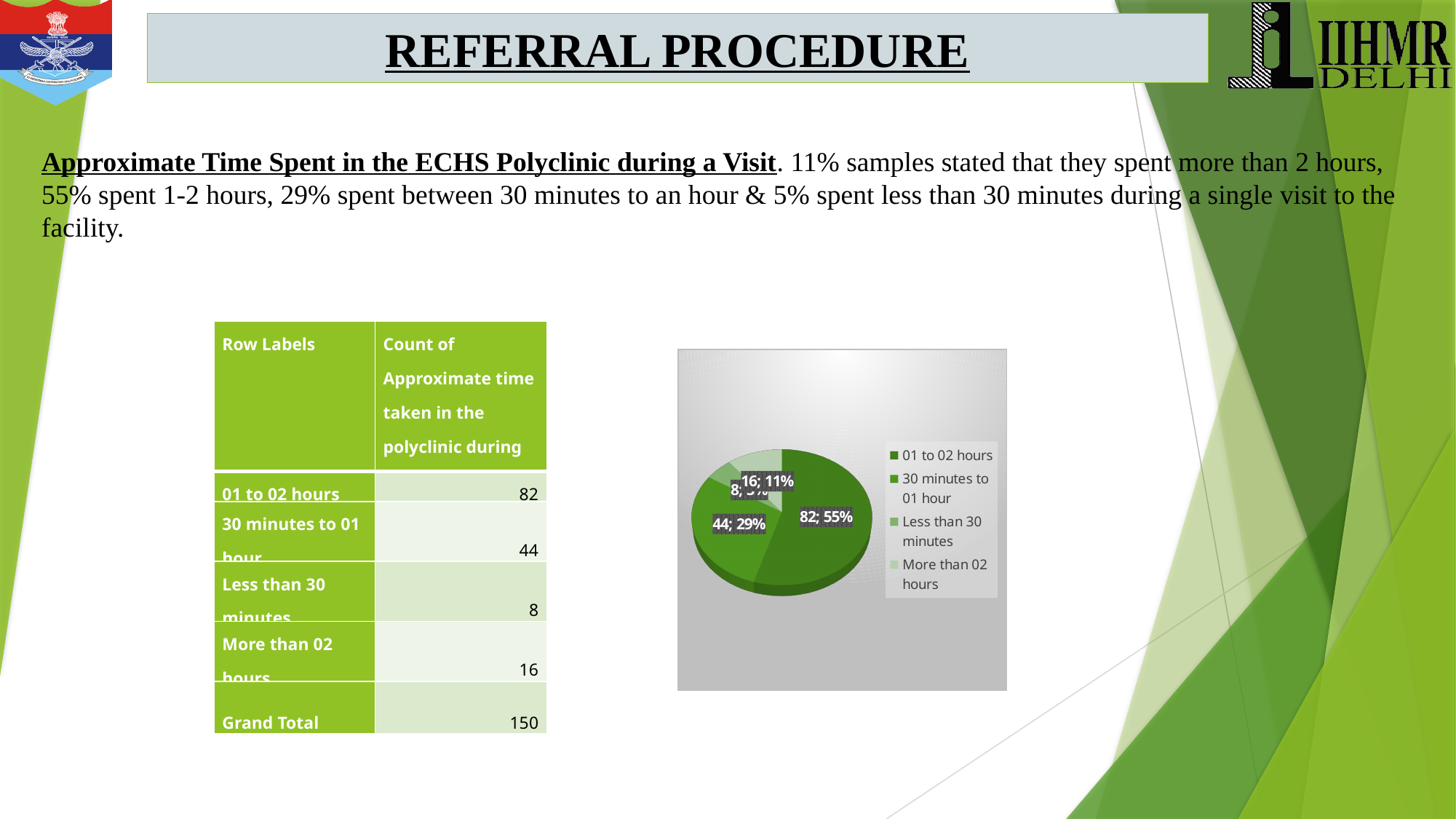
How many entries does the pie chart's legend list? 4 What kind of chart is shown on the slide? Pie chart In the pie chart, which is larger: the count for 'More than 02 hours' or the count for 'Less than 30 minutes'? More than 02 hours How many slices does the pie chart have? 4 What percentage share does the '01 to 02 hours' slice have in the pie chart? 55% What percentage share does the '30 minutes to 01 hour' slice have in the pie chart? 29% In the pie chart, what is the difference between the counts for '01 to 02 hours' and '30 minutes to 01 hour'? 38 What percentage share does the 'More than 02 hours' slice have in the pie chart? 11% Which category has the largest slice in the pie chart? 01 to 02 hours What count is shown for the '01 to 02 hours' slice of the pie chart? 82 Which category has the smallest slice in the pie chart? Less than 30 minutes What count is shown for the '30 minutes to 01 hour' slice of the pie chart? 44